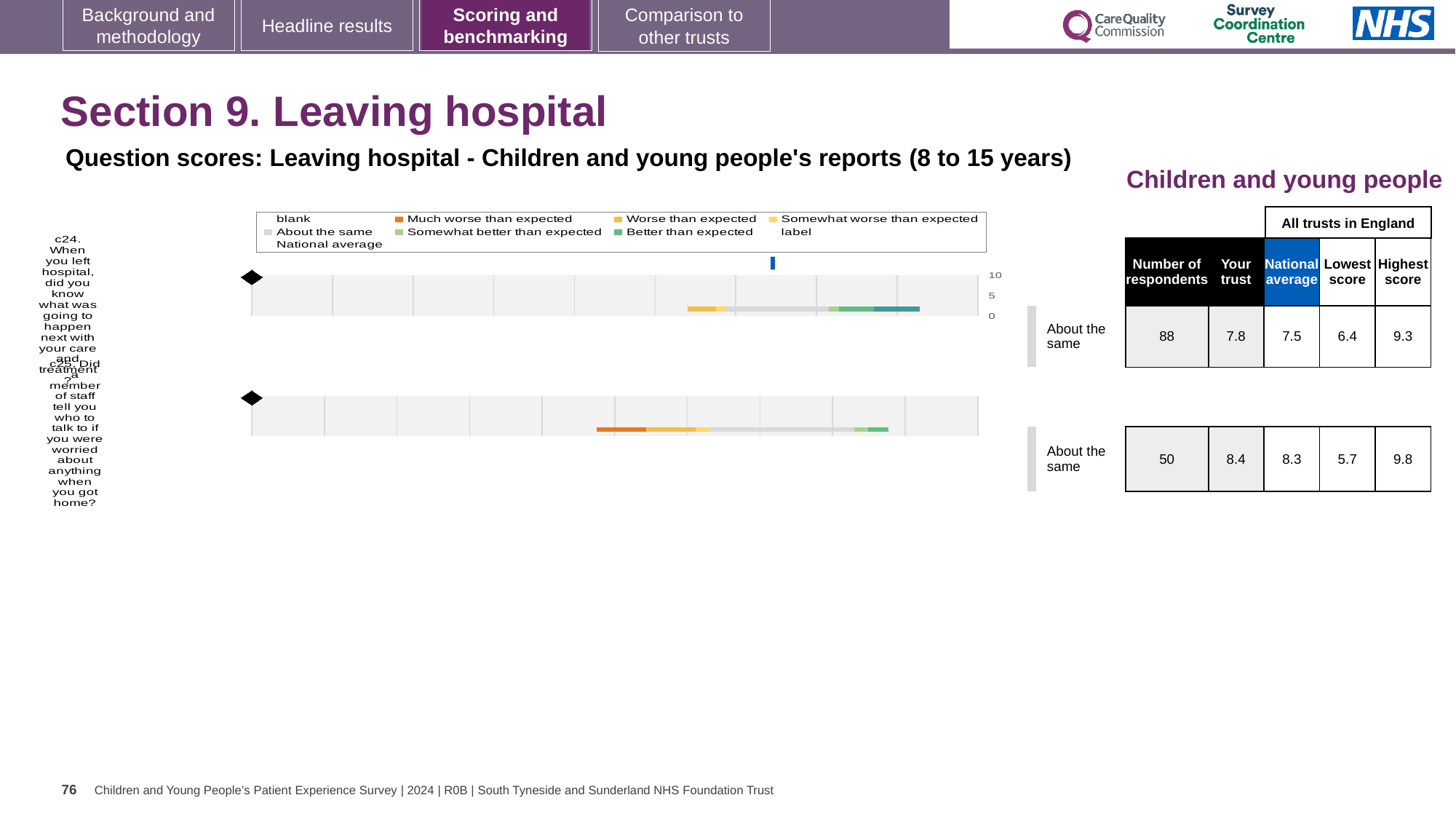
What is the difference between the highest and lowest scores for question c24? 2.9 Is the 'Your trust' score for question c24 greater or less than 5? greater Which legend entry is shown in orange? Much worse than expected What benchmark category is given for question c25? About the same How many questions (bars) are plotted on the slide? 2 What kind of chart is used to show the benchmarking for questions c24 and c25? bar chart What is the highest score among all trusts in England for question c25? 9.8 What is the national average score for question c24? 7.5 What is the lowest score among all trusts in England for question c24? 6.4 How many respondents answered question c25? 50 What is the 'Your trust' score for question c24? 7.8 Which is larger for question c25: the 'Your trust' score or the national average? Your trust